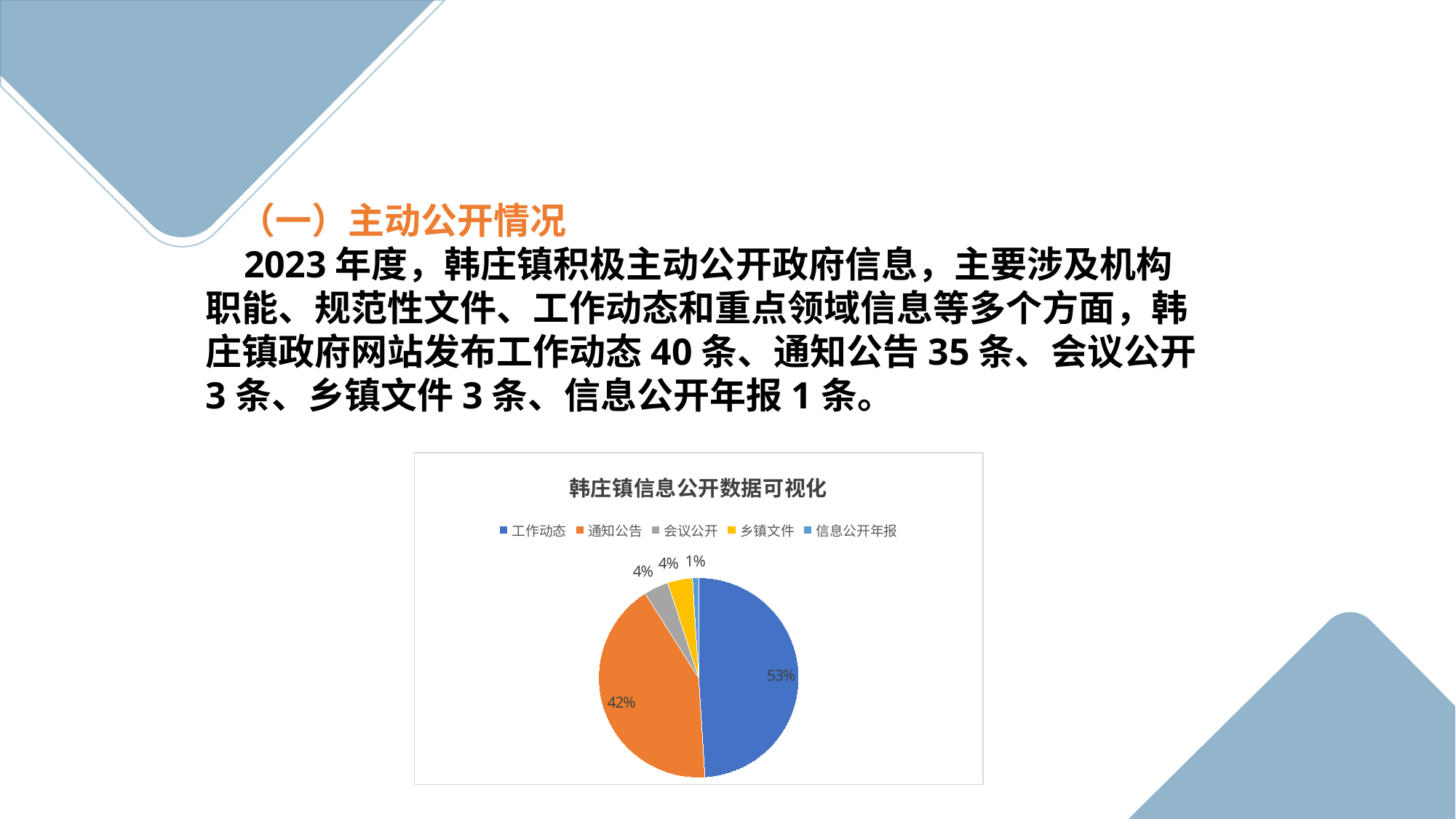
What percentage is shown for 通知公告? 42% What percentage is shown for 信息公开年报? 1% What percentage is shown for 会议公开? 4% Which is larger, the share for 通知公告 or the share for 乡镇文件? 通知公告 What percentage of the pie does 工作动态 account for? 53% Which category has the smallest share of the pie? 信息公开年报 How many entries does the legend list? 5 Which category has the largest share of the pie? 工作动态 What is the difference in percentage points between 工作动态 and 通知公告? 11% How many categories are shown in the pie chart? 5 What type of chart is shown on the slide? pie chart What is the title of the chart? 韩庄镇信息公开数据可视化